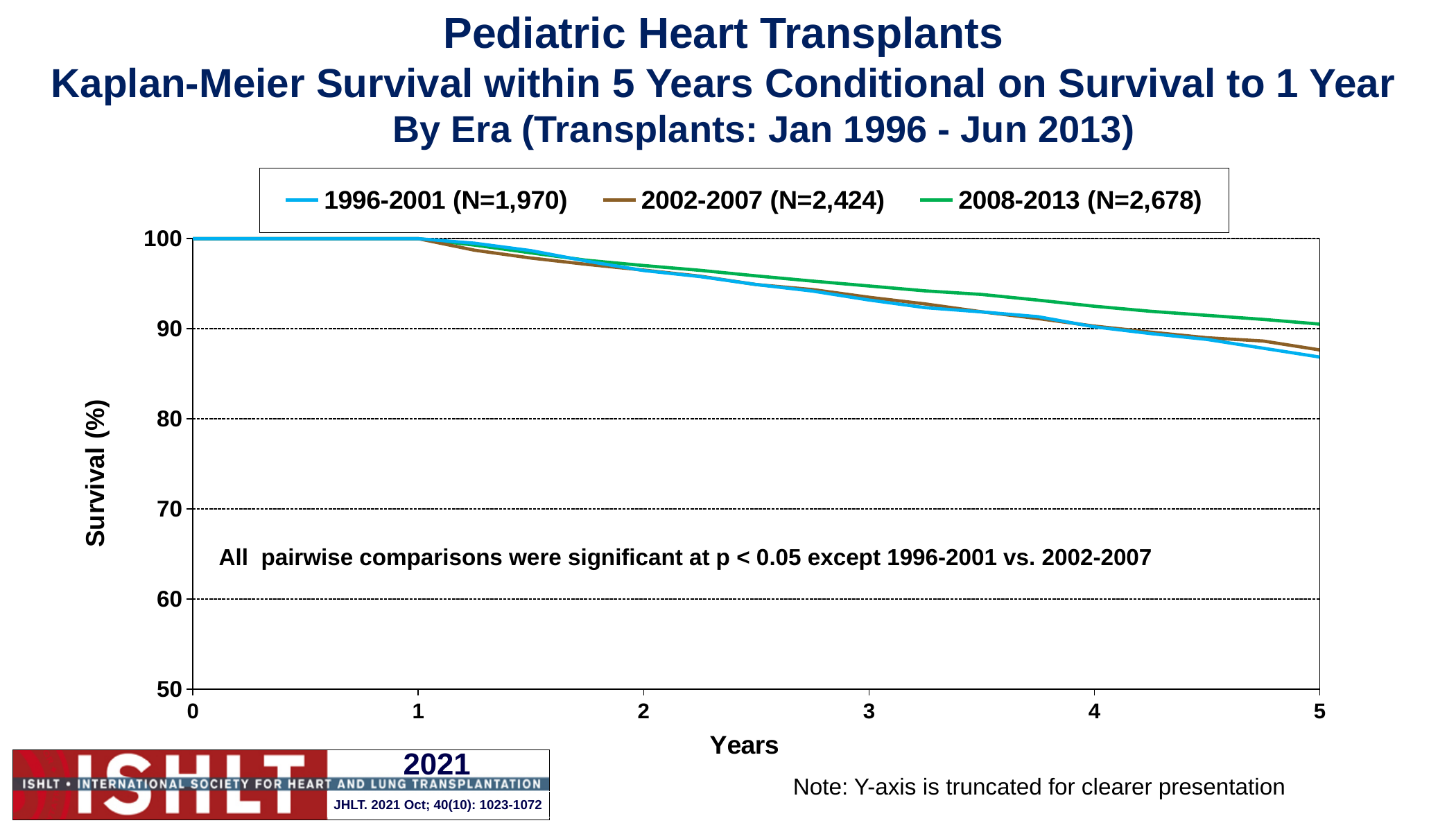
Which series has the highest survival at year 5? 2008-2013 (N=2,678) Is the survival value for the 2008-2013 series at year 4 greater or less than 90? greater Is the survival value for the 2002-2007 series at year 3 greater or less than 90? greater What kind of chart is shown on the slide? Line chart How many series does the legend list? 3 What is the label of the y-axis? Survival (%) Do the survival curves rise or fall as years increase from 1 to 5? fall At year 5, which series has the larger survival value: 1996-2001 or 2008-2013? 2008-2013 What is the survival value for the 2008-2013 series at year 1? 100 What is the survival value for the 1996-2001 series at year 1? 100 Is the survival value for the 1996-2001 series at year 5 greater or less than 90? less What is the N shown in the legend for the 2002-2007 series? 2,424